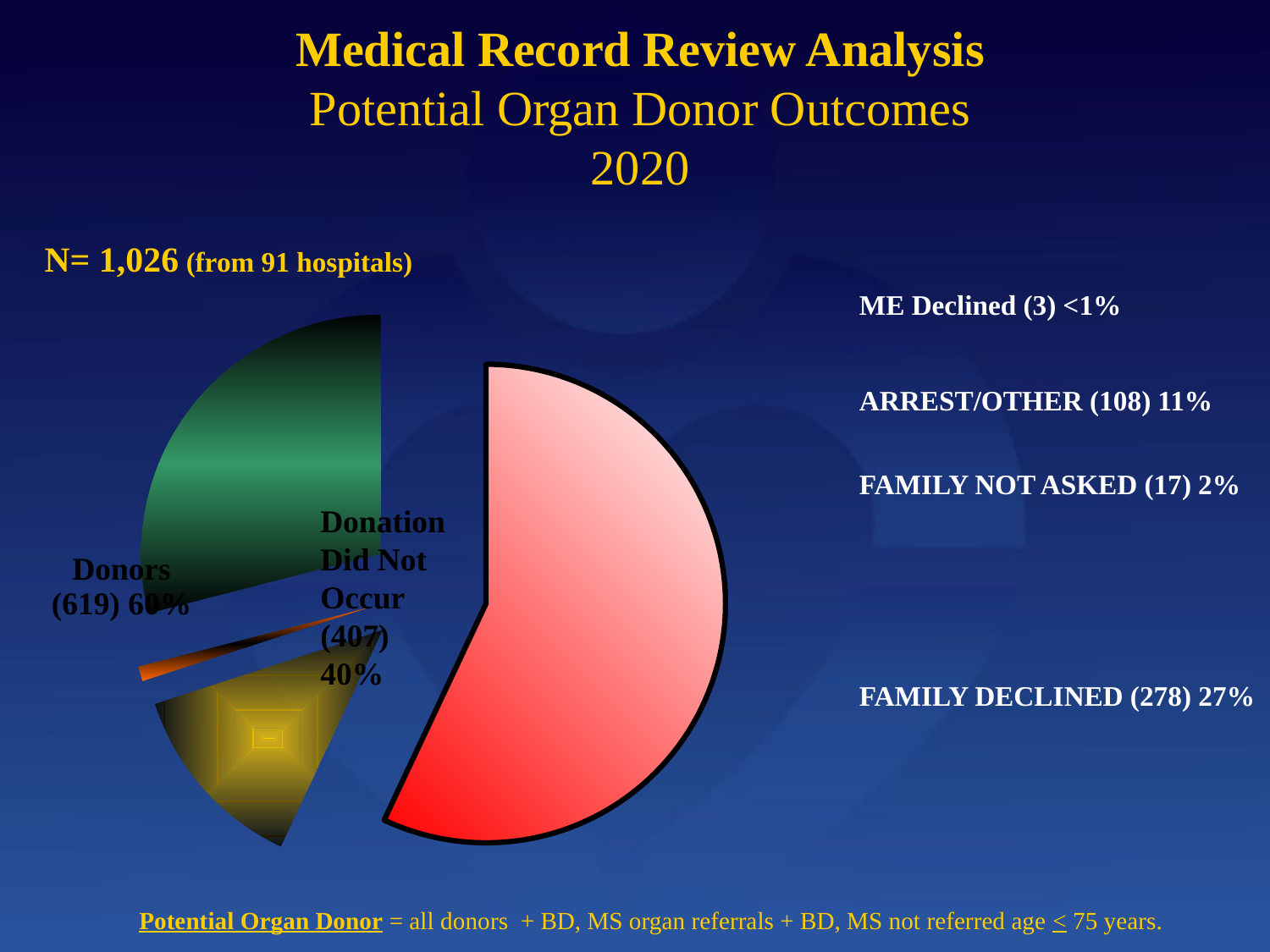
What kind of chart is shown on the slide? pie chart How many cases are in the 'Donation Did Not Occur' category? 407 What is the difference between the number of Donors and the number of cases where Donation Did Not Occur? 212 What percentage of potential organ donors fall under 'Donation Did Not Occur'? 40% What percentage is shown for FAMILY DECLINED? 27% How many cases are labelled FAMILY NOT ASKED? 17 How many potential organ donors became donors according to the chart? 619 How many cases are labelled ME Declined? 3 What percentage is shown for ARREST/OTHER? 11% How many cases are labelled FAMILY DECLINED? 278 Which is larger, FAMILY DECLINED or ARREST/OTHER? FAMILY DECLINED Which category has the largest share of the pie? Donors